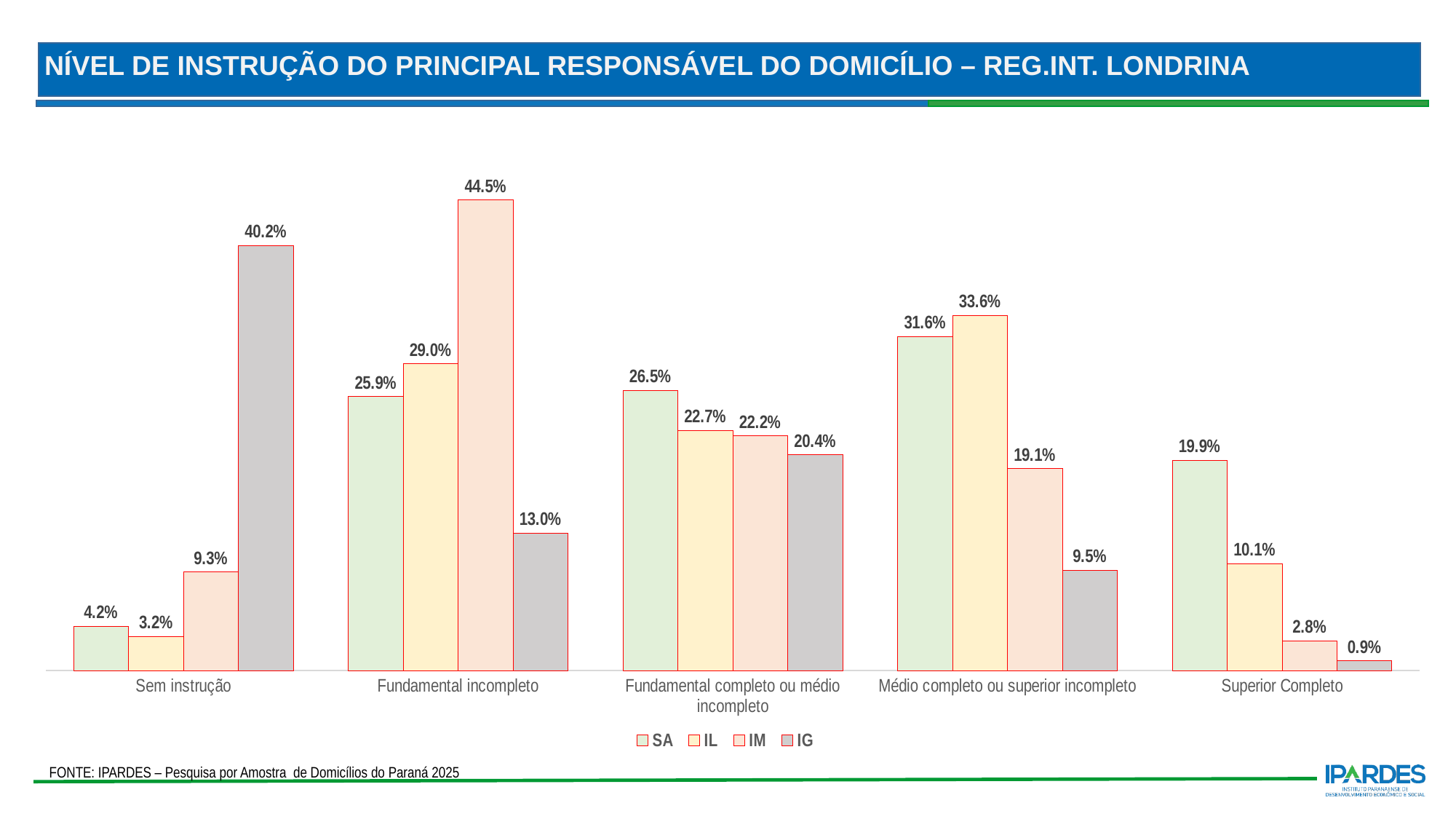
What is the difference between the IM and IG values in the 'Fundamental incompleto' category? 31.5% What is the value for IG in the 'Sem instrução' category? 40.2% How many series does the legend list? 4 What is the source cited at the bottom of the slide? IPARDES – Pesquisa por Amostra de Domicílios do Paraná 2025 How many education-level categories are shown on the x axis? 5 What is the difference between the SA and IL values in the 'Fundamental completo ou médio incompleto' category? 3.8% What kind of chart is shown on the slide? Bar chart What is the value for SA in the 'Superior Completo' category? 19.9% Which is larger in the 'Sem instrução' category: the SA value or the IL value? SA Which series has the highest value in the 'Médio completo ou superior incompleto' category? IL Which series has the lowest value in the 'Superior Completo' category? IG What is the value for IM in the 'Fundamental incompleto' category? 44.5%